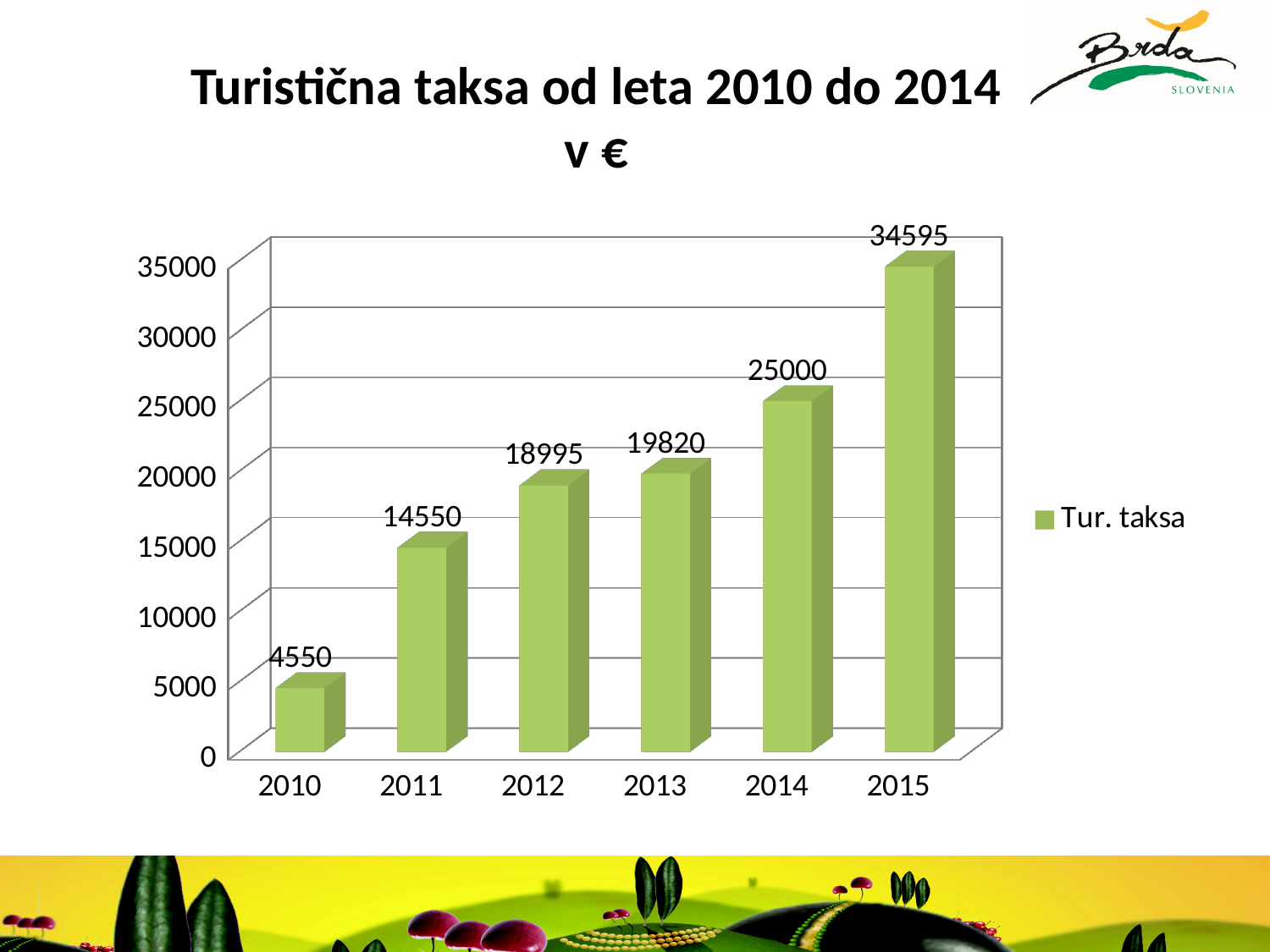
How many years are shown on the x axis? 6 What is the value for 2010? 4550 Which is larger, the value for 2012 or the value for 2013? 2013 Is the value for 2012 greater or less than 20000? less What is the difference between the values for 2015 and 2014? 9595 Which year has the lowest value? 2010 Which year has the highest value? 2015 What is the value for 2013? 19820 Do the values rise or fall from 2010 to 2015? rise What is the difference between the values for 2014 and 2011? 10450 What is the value for 2015? 34595 What kind of chart is shown? bar chart